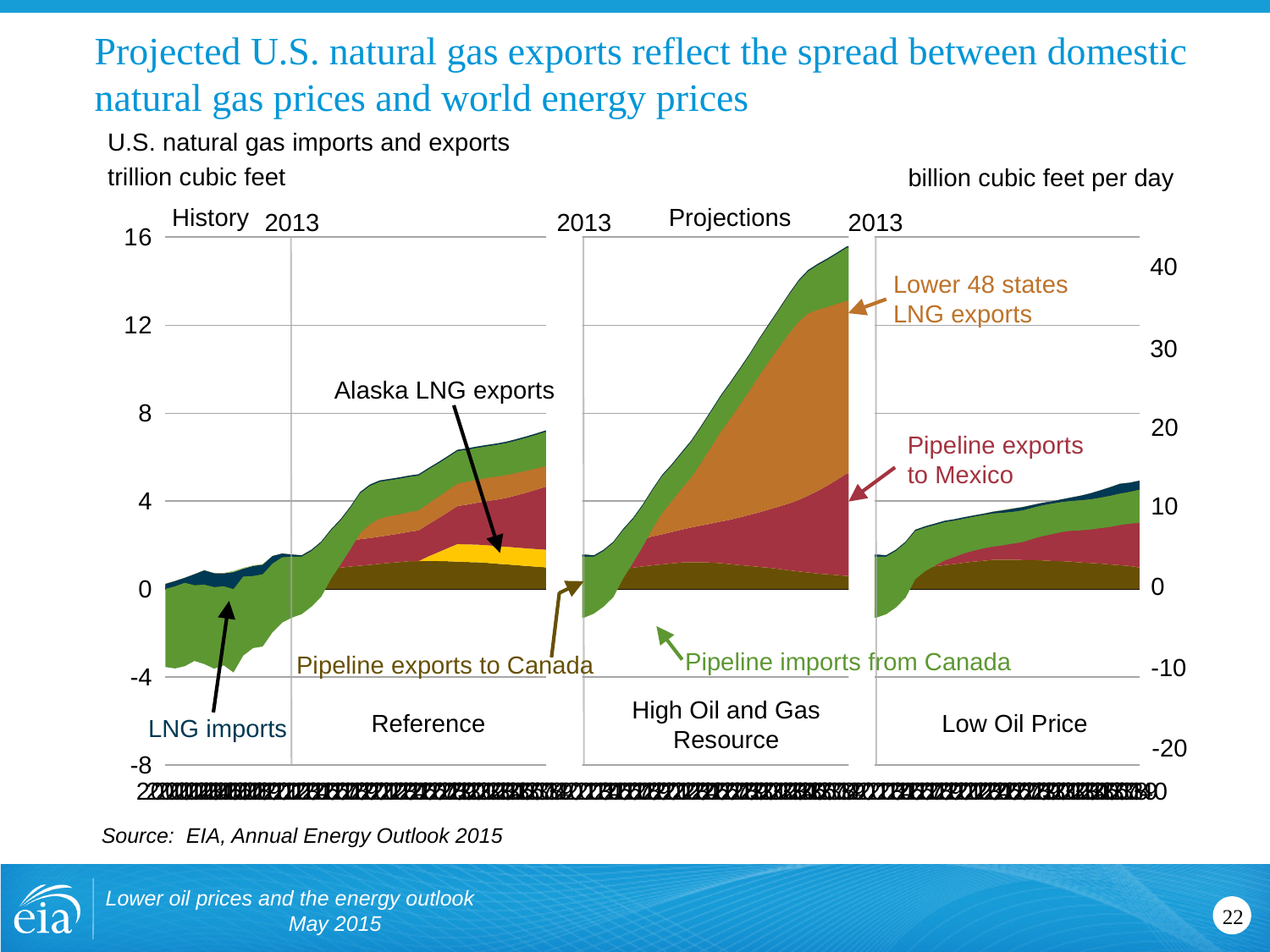
What unit is shown on the left axis of the chart? trillion cubic feet In the Low Oil Price scenario, is the total of exports at the end of the projection period greater or less than 8 trillion cubic feet? less How many projection scenarios are shown in the chart? 3 Which projection scenario reaches the highest total natural gas exports by the end of the projection period? High Oil and Gas Resource What is the title of the chart? U.S. natural gas imports and exports Which projection scenario has the lowest total natural gas exports at the end of the projection period? Low Oil Price Are total exports at the end of the projection period larger in the High Oil and Gas Resource scenario or in the Reference scenario? High Oil and Gas Resource What kind of chart is shown on the slide? stacked area chart In the High Oil and Gas Resource scenario, do total natural gas exports rise or fall over the projection period? rise In the High Oil and Gas Resource scenario, is the total of exports at the end of the projection period greater or less than 12 trillion cubic feet? greater In the Reference scenario, is the total of exports at the end of the projection period greater or less than 8 trillion cubic feet? less How many named import/export series are labeled on the chart? 6